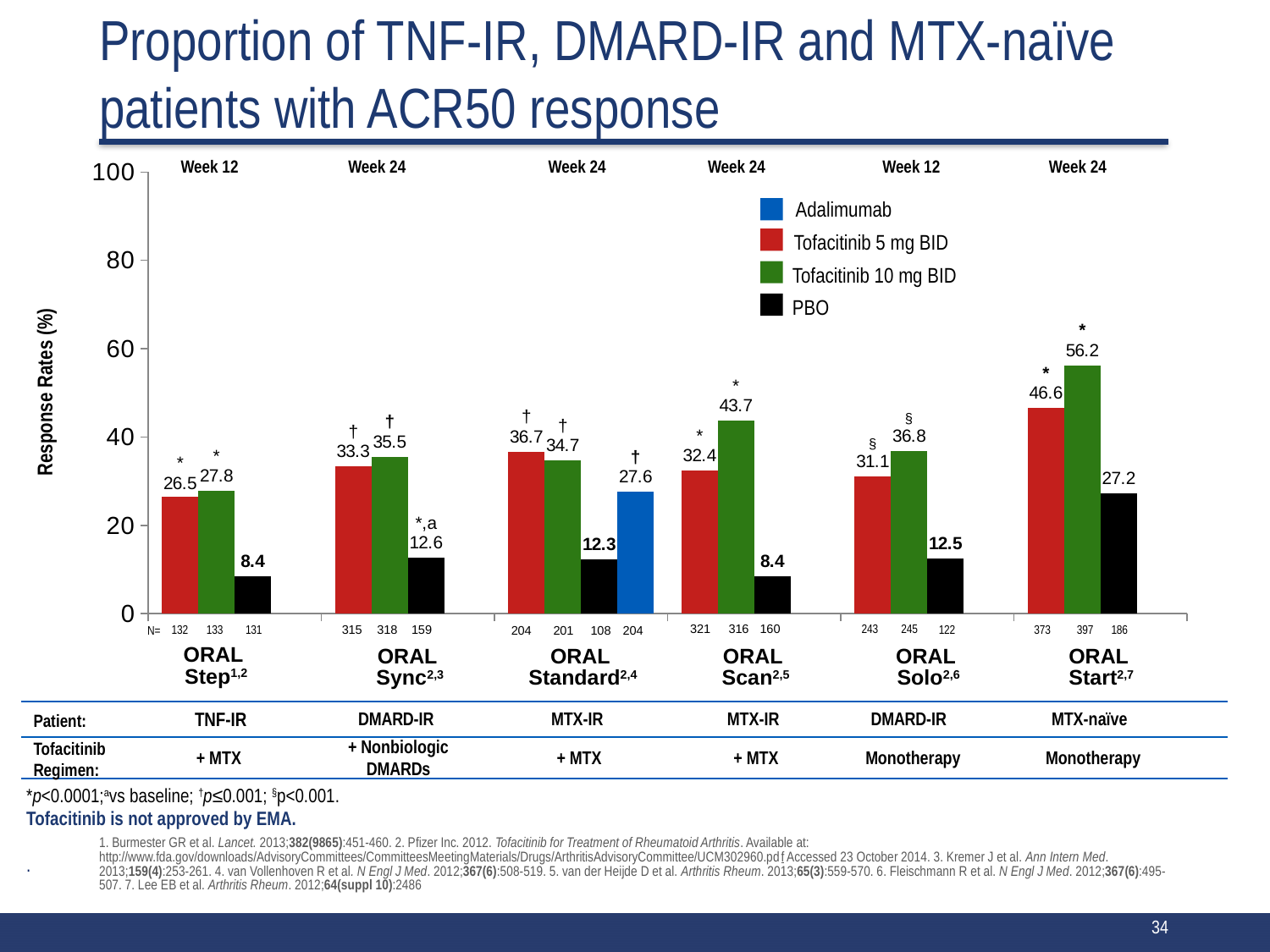
How many series does the legend list? 4 What is the ACR50 response rate for Adalimumab in ORAL Standard? 27.6 What is the ACR50 response rate for PBO in ORAL Step? 8.4 Which study has the highest Tofacitinib 10 mg BID response rate? ORAL Start What is the difference between the Tofacitinib 10 mg BID and PBO response rates in ORAL Scan? 35.3 What colour represents PBO in the legend? Black What is the ACR50 response rate for Tofacitinib 5 mg BID in ORAL Solo? 31.1 How many study groups are shown along the x axis? 6 What kind of chart is shown on the slide? Bar chart Which study has the lowest Tofacitinib 5 mg BID response rate? ORAL Step In ORAL Standard, which is larger: the Tofacitinib 5 mg BID response rate or the Tofacitinib 10 mg BID response rate? Tofacitinib 5 mg BID What is the ACR50 response rate for Tofacitinib 10 mg BID in ORAL Start? 56.2